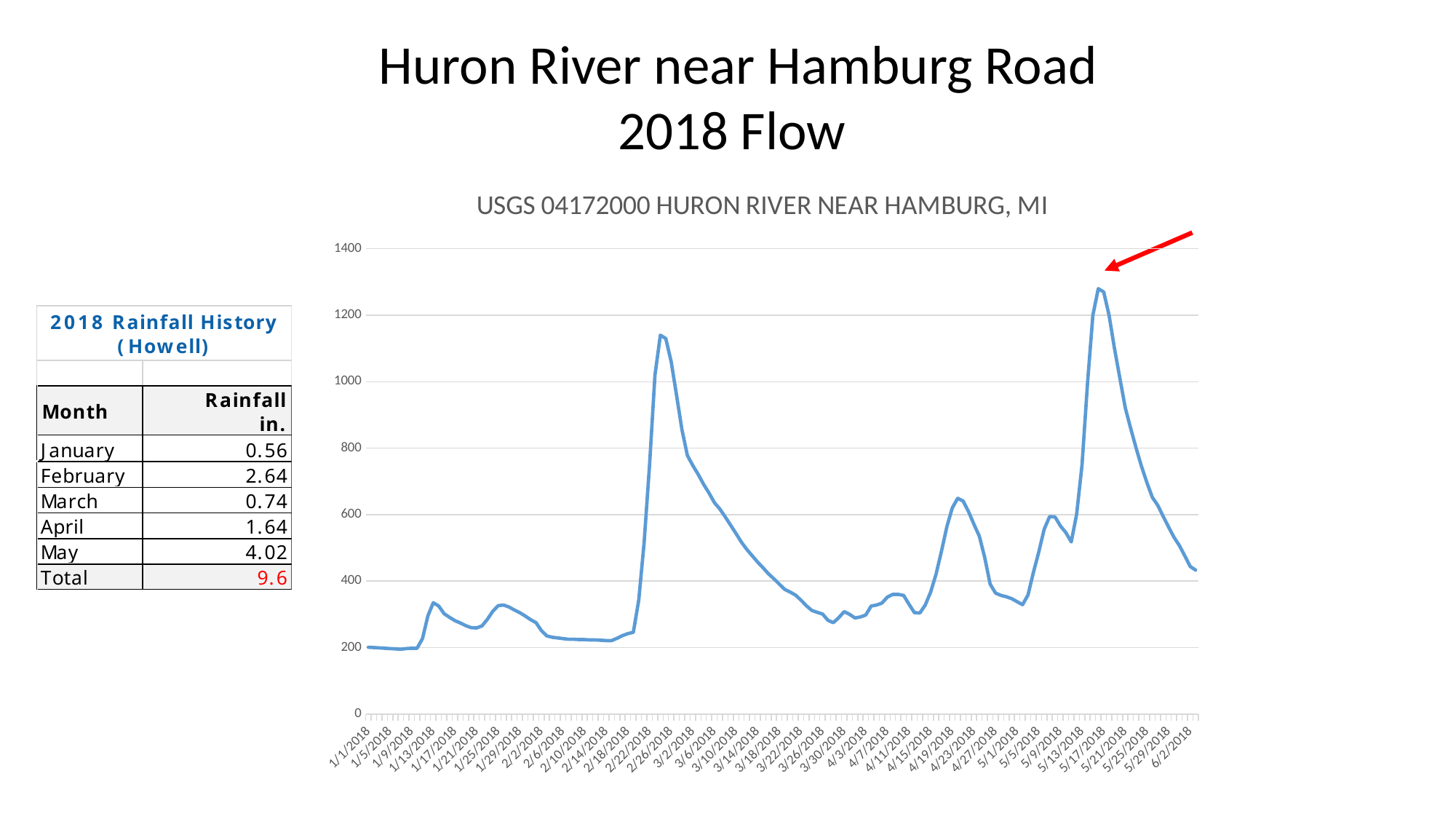
What is the title of the chart? USGS 04172000 HURON RIVER NEAR HAMBURG, MI Is the value for 6/2/2018 greater or less than 600? less Is the value for 2/26/2018 greater or less than 1000? greater Do the values rise or fall between 2/26/2018 and 3/30/2018? fall What kind of chart is shown on the slide? line chart Is the value for 3/30/2018 greater or less than 400? less What is the highest value labelled on the y axis? 1400 Which is larger, the peak value near 2/26/2018 or the peak value near 5/17/2018? 5/17/2018